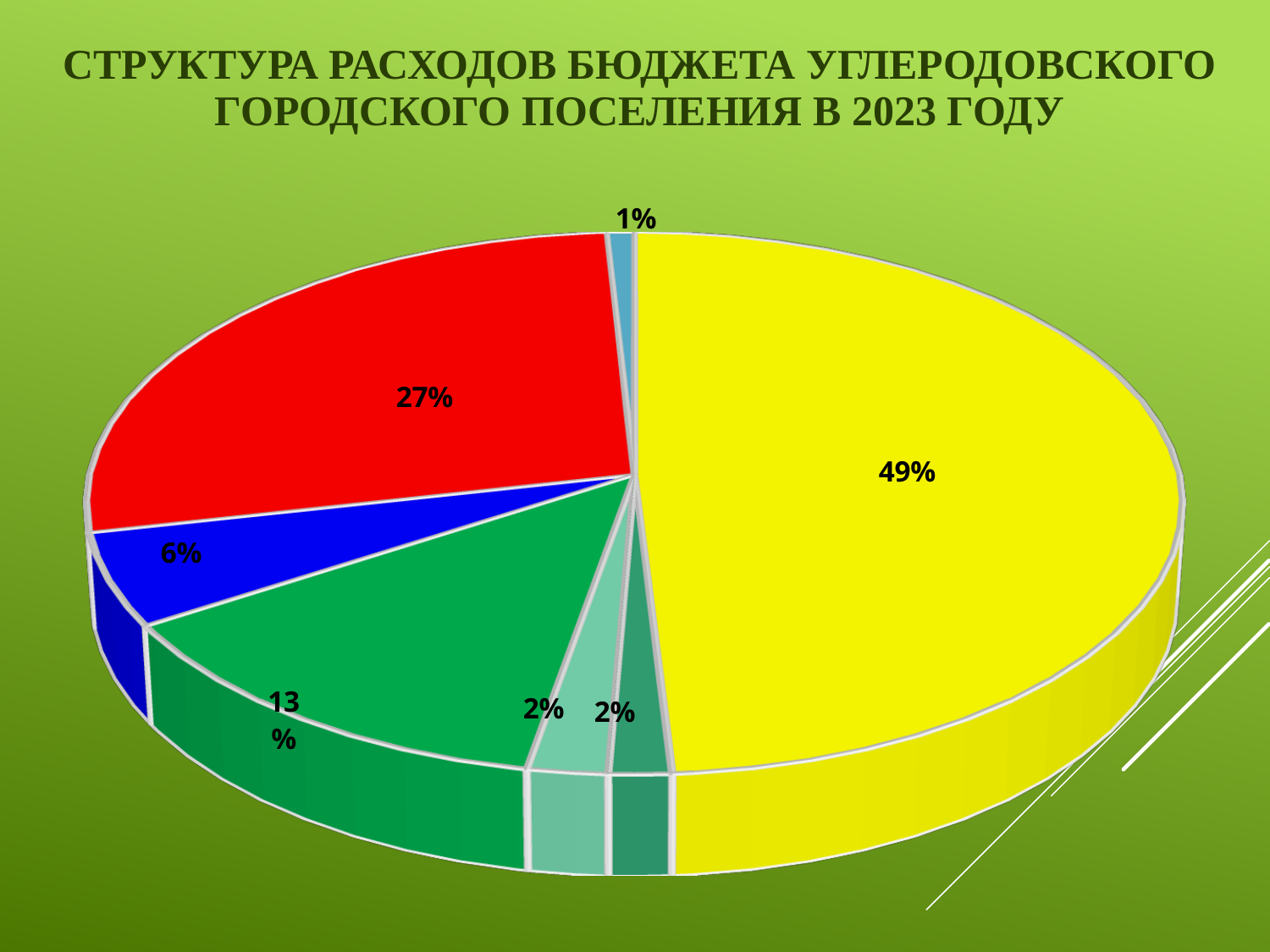
Which slice is the smallest in the pie chart? the light blue slice (1%) What share does the blue slice represent? 6% What share does the light blue slice at the top of the pie represent? 1% What is the difference between the yellow slice and the red slice? 22% What share does the red slice represent? 27% What kind of chart is shown on the slide? pie chart Which is larger, the dark green slice or the blue slice? the dark green slice (13%) How many slices does the pie chart have? 7 Which slice is the largest in the pie chart? the yellow slice (49%) What share does the yellow slice represent? 49% What is the title of the chart? СТРУКТУРА РАСХОДОВ БЮДЖЕТА УГЛЕРОДОВСКОГО ГОРОДСКОГО ПОСЕЛЕНИЯ В 2023 ГОДУ What share does the dark green slice represent? 13%